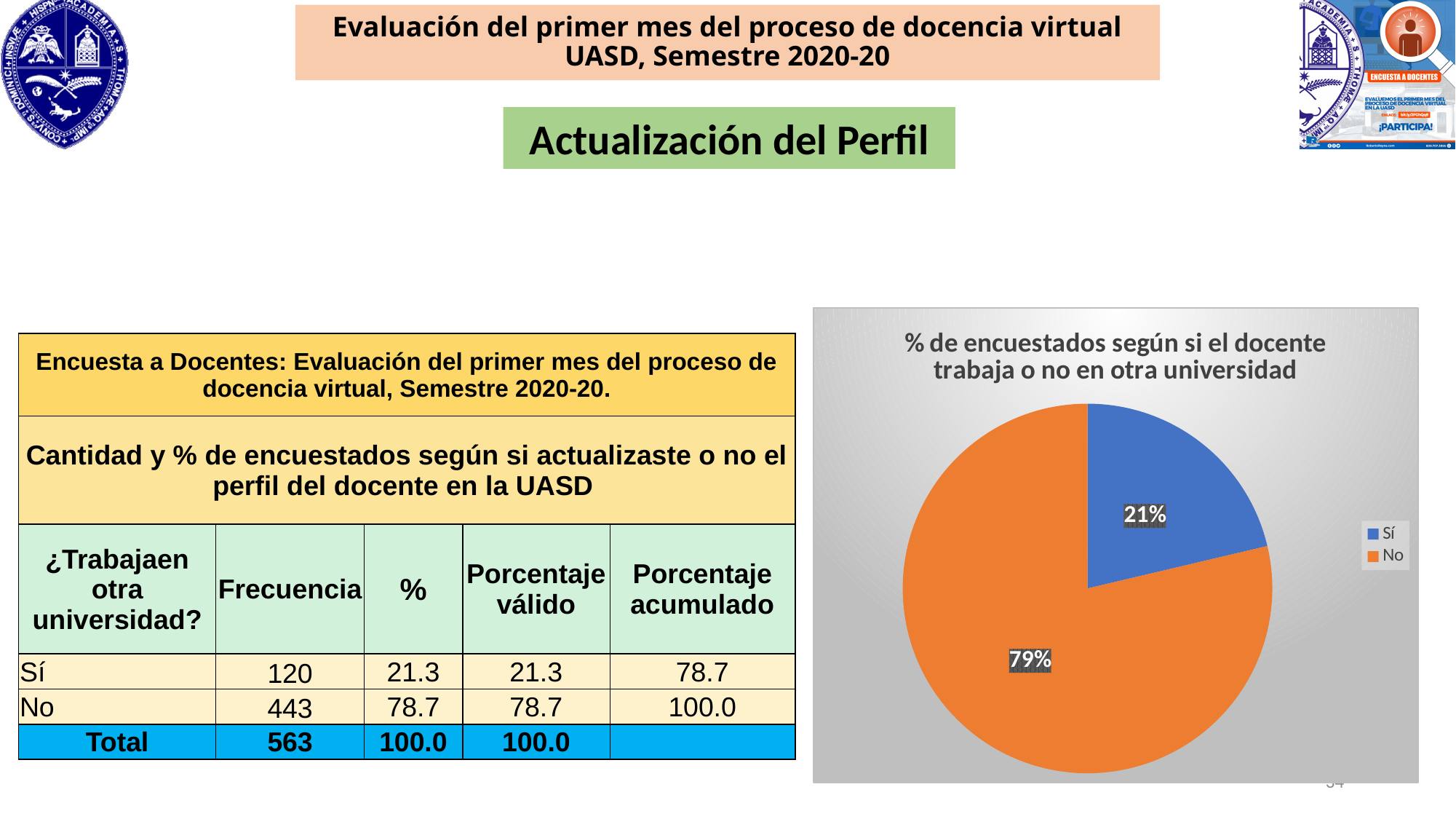
What colour is the 'No' slice in the pie chart? orange What share of the pie does the 'Sí' slice represent? 21% What is the difference in percentage points between the 'No' slice and the 'Sí' slice in the pie chart? 58 Which is larger in the pie chart, the 'Sí' slice or the 'No' slice? No Which slice of the pie chart is the largest? No What kind of chart is shown on the slide? pie chart How many slices does the pie chart have? 2 Which slice of the pie chart is the smallest? Sí How many entries does the legend of the pie chart list? 2 What is the title of the pie chart? % de encuestados según si el docente trabaja o no en otra universidad What percentage does the 'No' slice show in the pie chart? 79% What percentage does the 'Sí' slice show in the pie chart? 21%